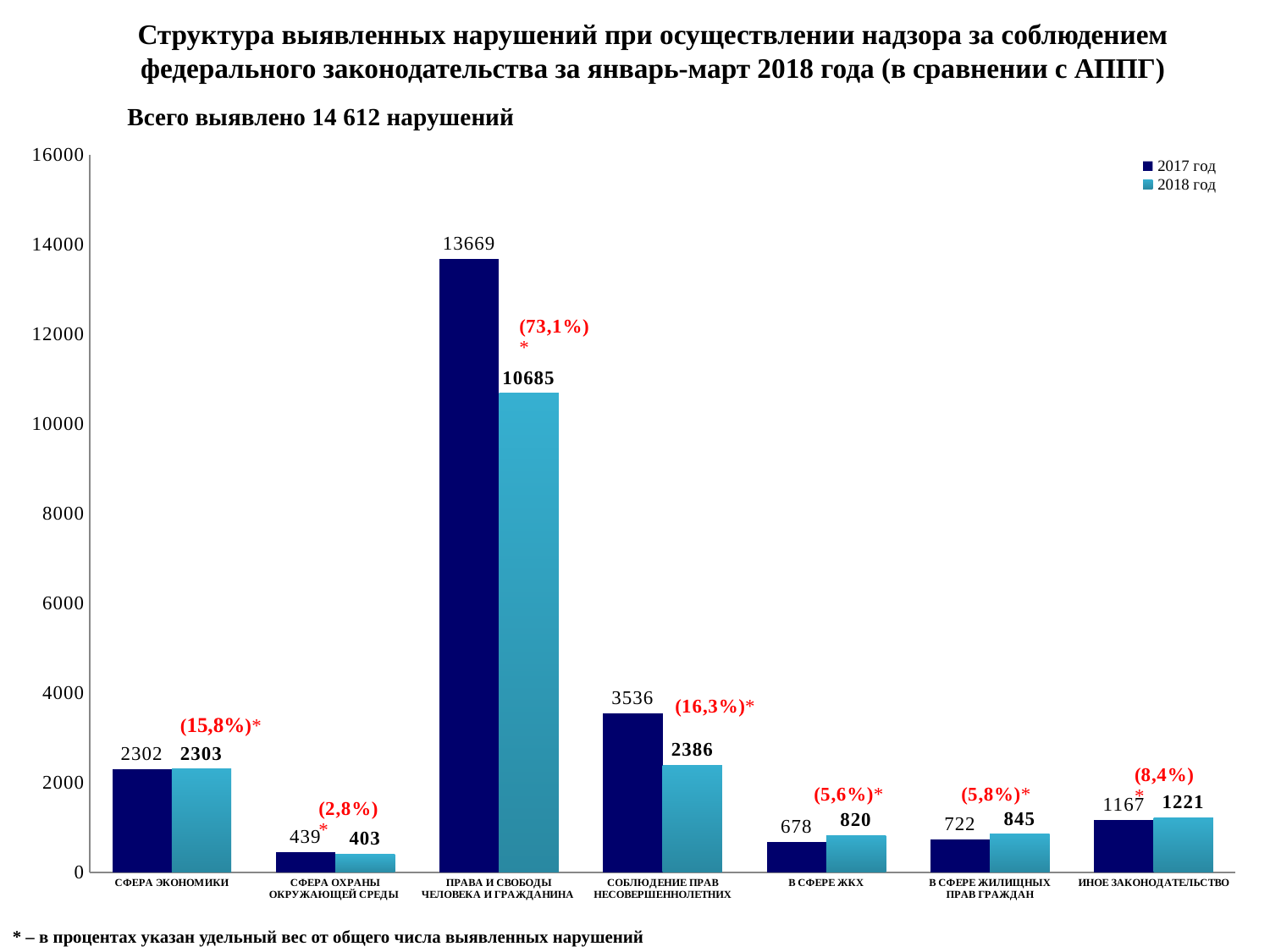
Is the 2017 год value for СОБЛЮДЕНИЕ ПРАВ НЕСОВЕРШЕННОЛЕТНИХ greater or less than 4000? less Which category has the highest 2018 год value? ПРАВА И СВОБОДЫ ЧЕЛОВЕКА И ГРАЖДАНИНА What is the 2018 год value for В СФЕРЕ ЖИЛИЩНЫХ ПРАВ ГРАЖДАН? 845 Which category has the lowest 2017 год value? СФЕРА ОХРАНЫ ОКРУЖАЮЩЕЙ СРЕДЫ What is the difference between the 2017 год and 2018 год values for ПРАВА И СВОБОДЫ ЧЕЛОВЕКА И ГРАЖДАНИНА? 2984 How many series does the legend list? 2 What percentage share is shown in red above the ПРАВА И СВОБОДЫ ЧЕЛОВЕКА И ГРАЖДАНИНА bars? (73,1%) What is the 2018 год value for СОБЛЮДЕНИЕ ПРАВ НЕСОВЕРШЕННОЛЕТНИХ? 2386 How many categories are shown on the x axis? 7 What type of chart is shown on the slide? bar chart Which is larger for В СФЕРЕ ЖКХ: the 2017 год value or the 2018 год value? 2018 год What is the 2017 год value for ПРАВА И СВОБОДЫ ЧЕЛОВЕКА И ГРАЖДАНИНА? 13669